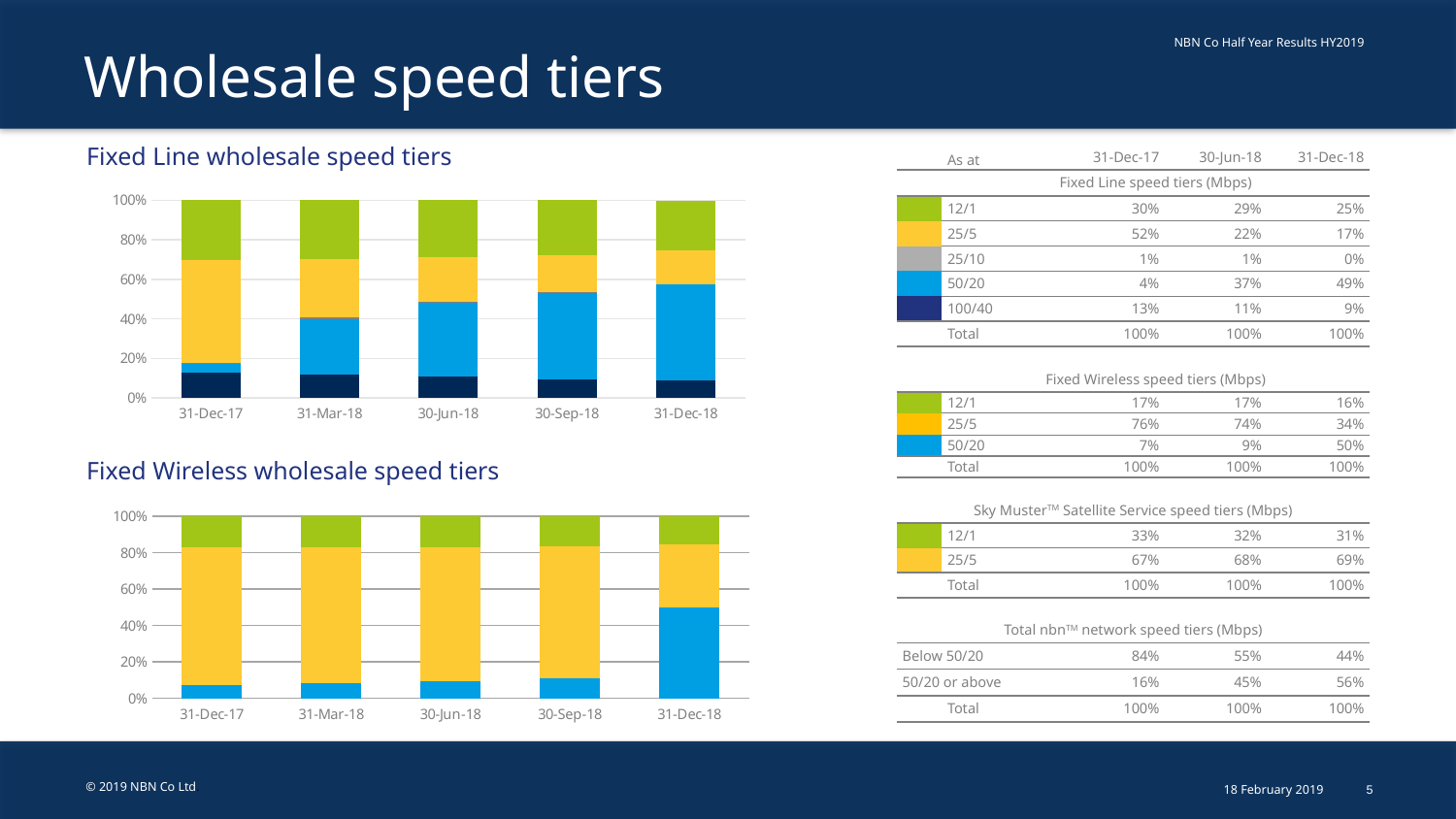
How many bars are in the 'Fixed Wireless wholesale speed tiers' chart? 5 What kind of chart is the 'Fixed Line wholesale speed tiers' chart? Stacked bar chart How many dates are shown on the x axis of the 'Fixed Line wholesale speed tiers' chart? 5 In the 'Fixed Line wholesale speed tiers' chart, does the light blue segment rise or fall from 31-Dec-17 to 31-Dec-18? Rise What is the first date label on the x axis of the 'Fixed Line wholesale speed tiers' chart? 31-Dec-17 In the 'Fixed Wireless wholesale speed tiers' chart, which date has the largest light blue segment? 31-Dec-18 What is the highest value shown on the y axis of the 'Fixed Wireless wholesale speed tiers' chart? 100% In the 'Fixed Wireless wholesale speed tiers' chart, does the yellow segment rise or fall from 31-Dec-17 to 31-Dec-18? Fall In the 'Fixed Wireless wholesale speed tiers' chart, is the top of the light blue segment for 31-Dec-18 greater or less than 40%? greater In the 'Fixed Line wholesale speed tiers' chart, which is larger for 31-Dec-18: the light blue segment or the yellow segment? The light blue segment In the 'Fixed Wireless wholesale speed tiers' chart, which is larger for 31-Dec-17: the yellow segment or the green segment? The yellow segment In the 'Fixed Wireless wholesale speed tiers' chart, is the top of the light blue segment for 31-Dec-17 greater or less than 20%? less